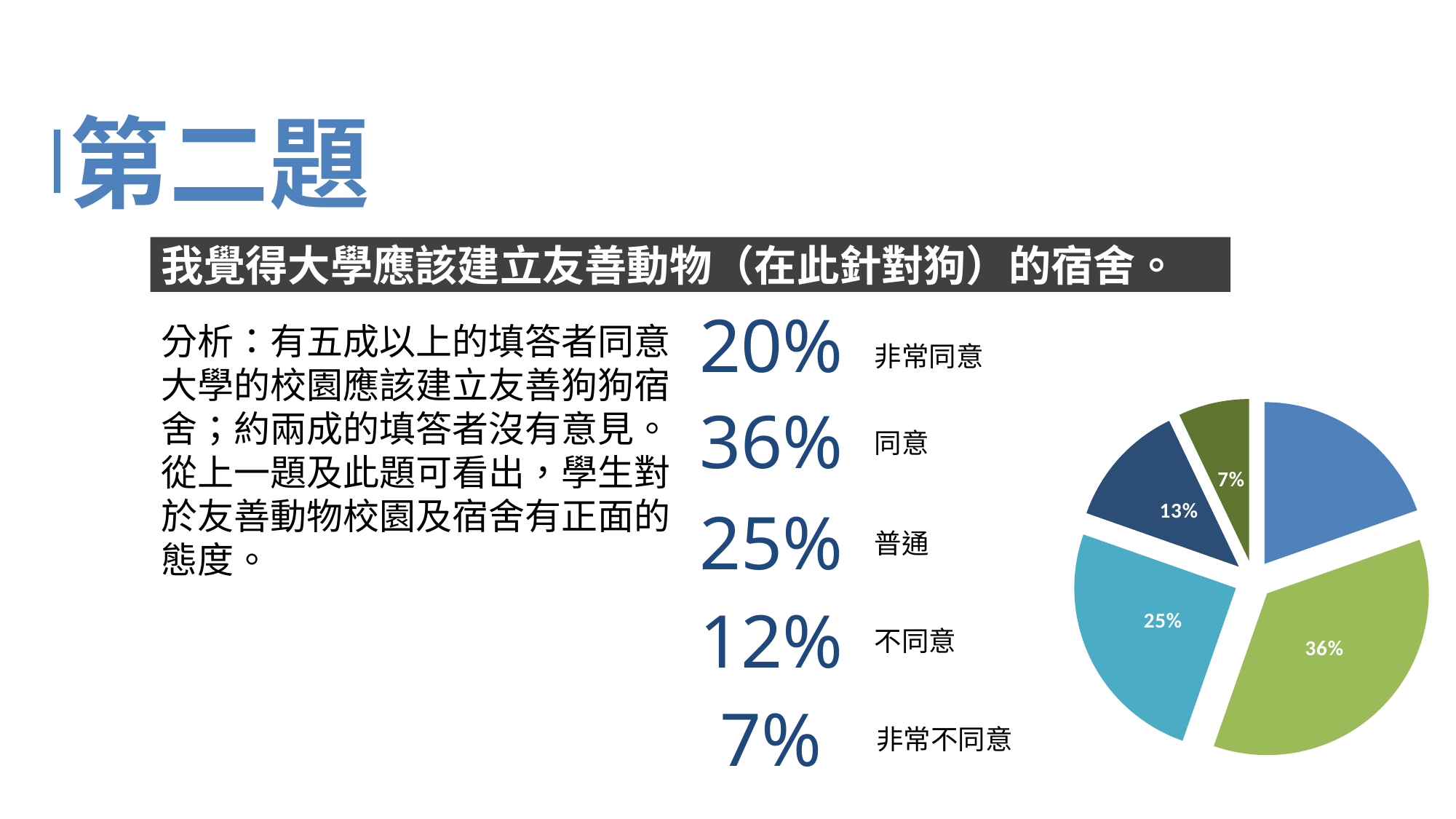
What percentage is shown on the teal (light blue) slice of the pie chart? 25% What is the largest value labelled on the pie chart? 36% According to the slide, what share of respondents answered 同意? 36% What percentage is shown on the dark navy slice of the pie chart? 13% What is the smallest value labelled on the pie chart? 7% Which is larger in the pie chart, the slice labelled 25% or the slice labelled 13%? 25% According to the slide, what share of respondents answered 非常同意? 20% What is the difference between the 36% slice and the 25% slice in the pie chart? 11% How many slices does the pie chart have? 5 What percentage is shown on the dark olive green slice of the pie chart? 7% What kind of chart is shown on the slide? pie chart What percentage is shown on the light green slice of the pie chart? 36%